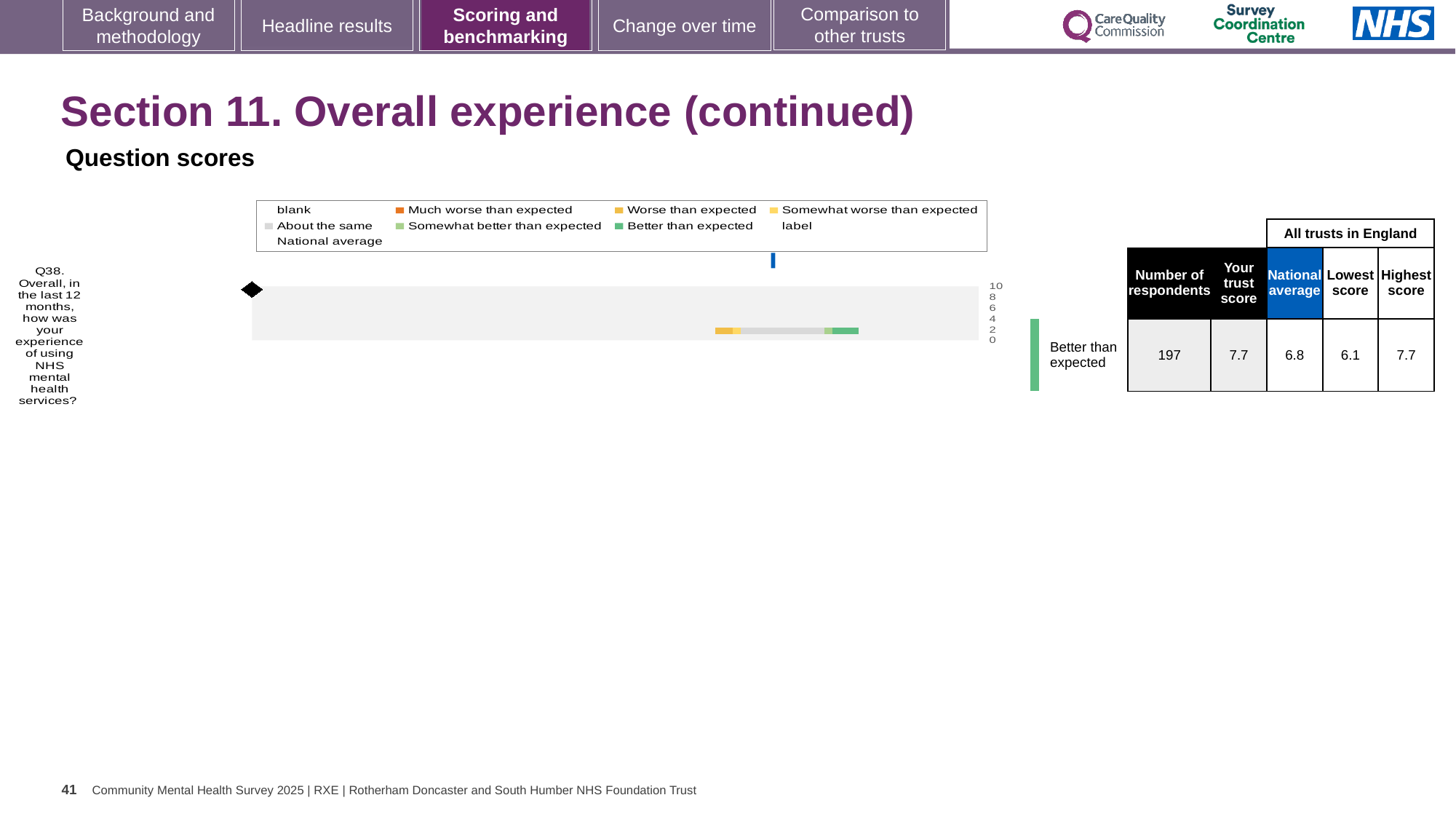
What is the national average score for Q38? 6.8 How many survey questions are plotted in the chart on this slide? 1 Is the trust's score for Q38 greater or less than 6 on the chart's scale? greater What is the lowest score among all trusts in England for Q38? 6.1 Which is larger for Q38, the trust's score or the national average? the trust's score What is the difference between the highest and lowest scores among all trusts in England for Q38? 1.6 What is the number of respondents for Q38? 197 What kind of chart is shown on the slide for Q38? bar chart What is the highest score among all trusts in England for Q38? 7.7 What is the trust's score for Q38? 7.7 What is the difference between the trust's score and the national average for Q38? 0.9 Which benchmark category label is shown next to the bar for Q38? Better than expected